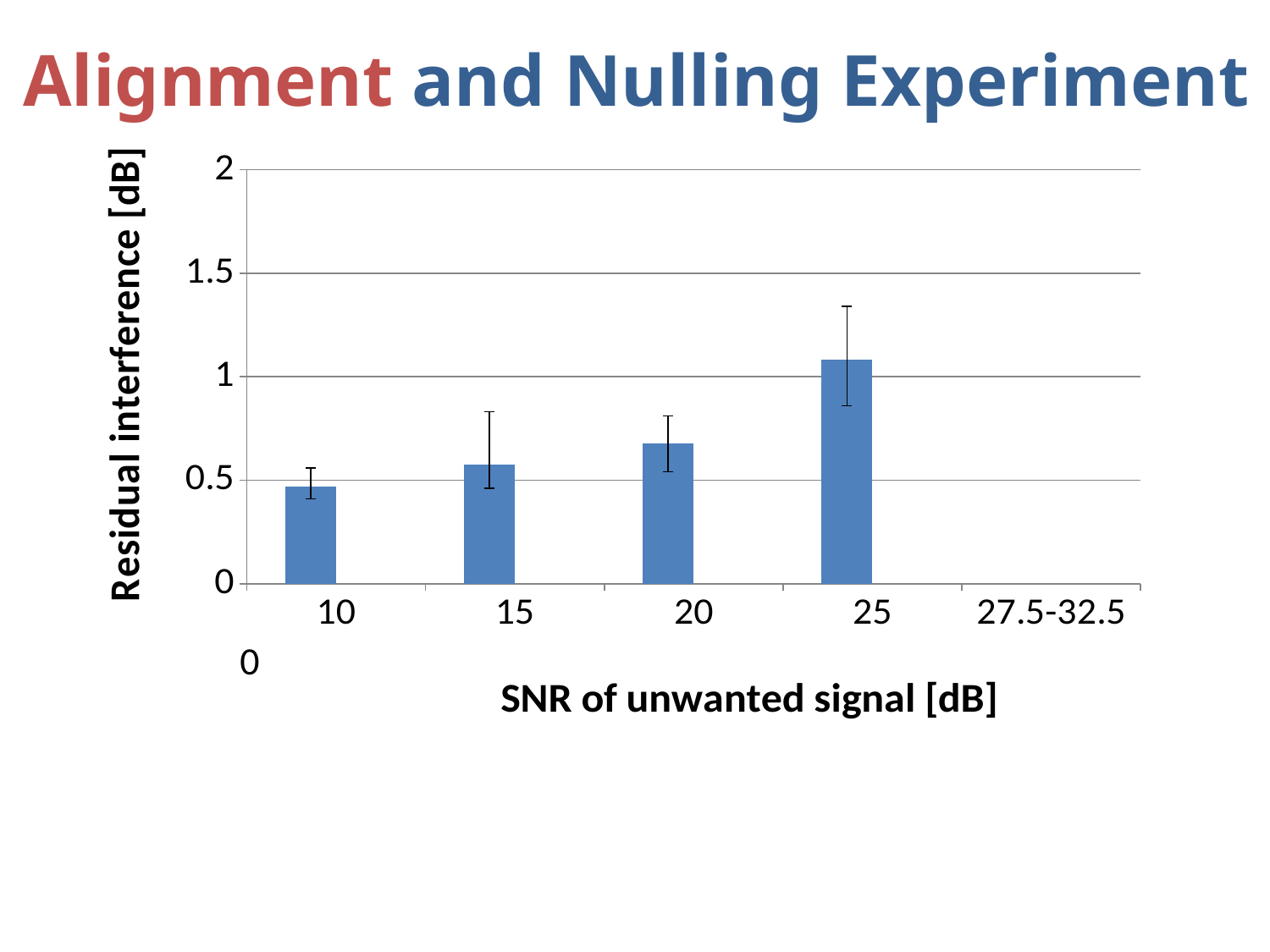
Which has a larger residual interference, SNR 10 or SNR 20? 20 Among the plotted bars, which SNR category has the lowest residual interference? 10 Which SNR category has the highest residual interference? 25 How many bars are plotted in the chart? 4 What kind of chart is shown on the slide? bar chart Do the bar values rise or fall as the SNR of the unwanted signal increases from 10 to 25? rise Is the residual interference for SNR 20 greater or less than 0.5? greater Which has a larger residual interference, SNR 20 or SNR 25? 25 Is the residual interference for SNR 10 greater or less than 0.5? less Is the residual interference for SNR 25 greater or less than 1? greater How many category labels appear on the x axis of the chart? 5 What is the label of the y axis of the chart? Residual interference [dB]